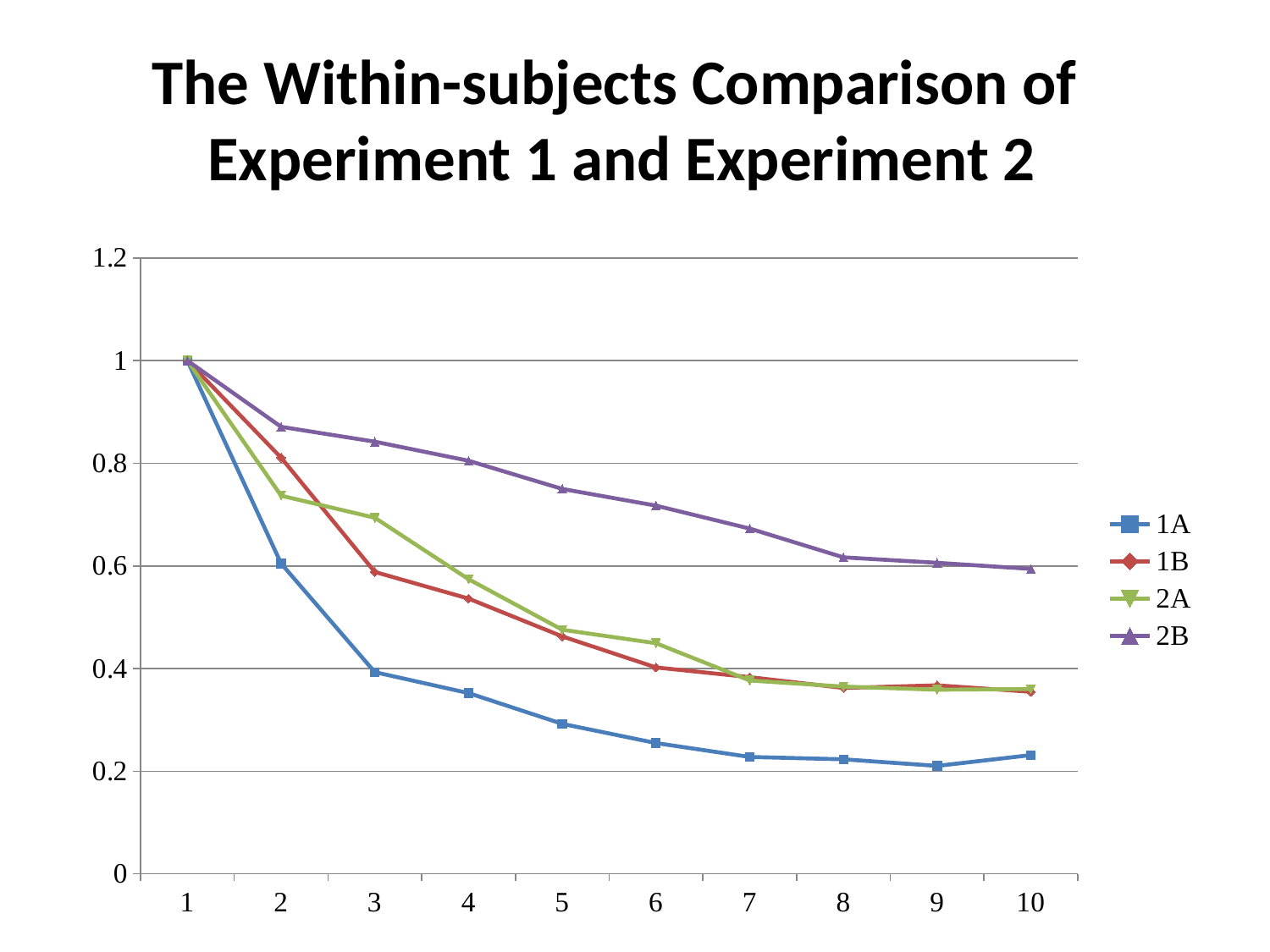
What type of chart is shown on the slide? line chart How many series does the legend list? 4 Is the value for series 2A at x = 2 greater or less than 0.6? greater Do the values of series 1A rise or fall from x = 1 to x = 9? fall At x = 4, which series has the larger value, 2B or 1A? 2B Which series has the highest value at x = 10? 2B Is the value for series 2B at x = 5 greater or less than 0.6? greater What is the title of the chart? The Within-subjects Comparison of Experiment 1 and Experiment 2 Is the value for series 1A at x = 5 greater or less than 0.4? less What is the value of series 1A at x = 1? 1 Which series has the lowest value at x = 10? 1A How many points are plotted along the x axis for each series? 10